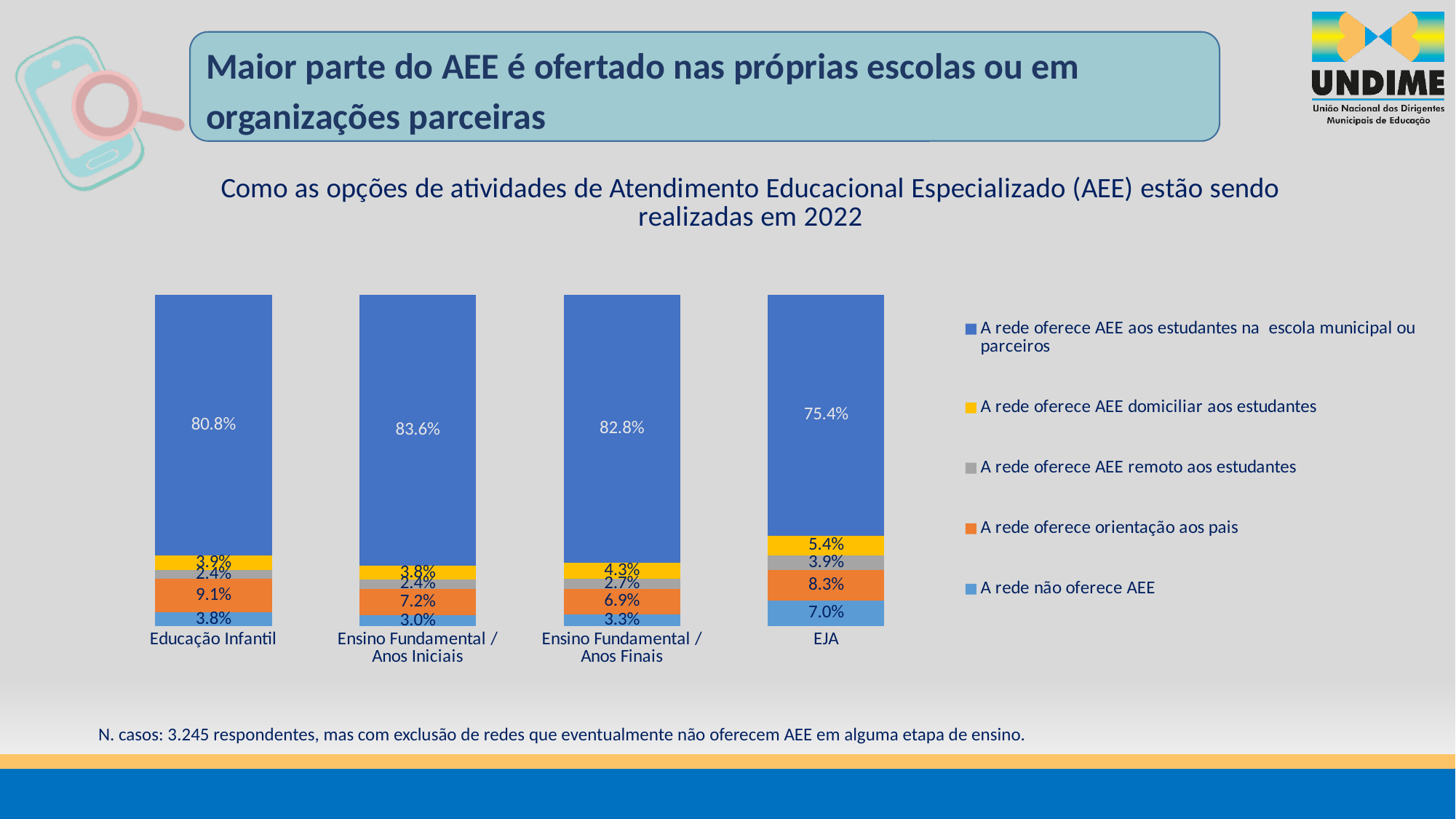
Which category has the lowest value for 'A rede oferece AEE aos estudantes na escola municipal ou parceiros'? EJA What is the value for 'A rede oferece orientação aos pais' for Educação Infantil? 9.1% What is the value for 'A rede oferece AEE domiciliar aos estudantes' for Ensino Fundamental / Anos Finais? 4.3% How many series does the legend list? 5 What kind of chart is shown on the slide? stacked bar chart How many categories (education stages) are shown on the x axis? 4 What is the value for 'A rede oferece AEE aos estudantes na escola municipal ou parceiros' for Ensino Fundamental / Anos Iniciais? 83.6% What is the value for 'A rede oferece AEE aos estudantes na escola municipal ou parceiros' for EJA? 75.4% What is the difference between the 'A rede não oferece AEE' values for EJA and Ensino Fundamental / Anos Iniciais? 4.0% Which category has the highest value for 'A rede oferece AEE aos estudantes na escola municipal ou parceiros'? Ensino Fundamental / Anos Iniciais What is the value for 'A rede não oferece AEE' for EJA? 7.0% Which is larger: the 'A rede oferece orientação aos pais' value for Educação Infantil or for Ensino Fundamental / Anos Finais? Educação Infantil